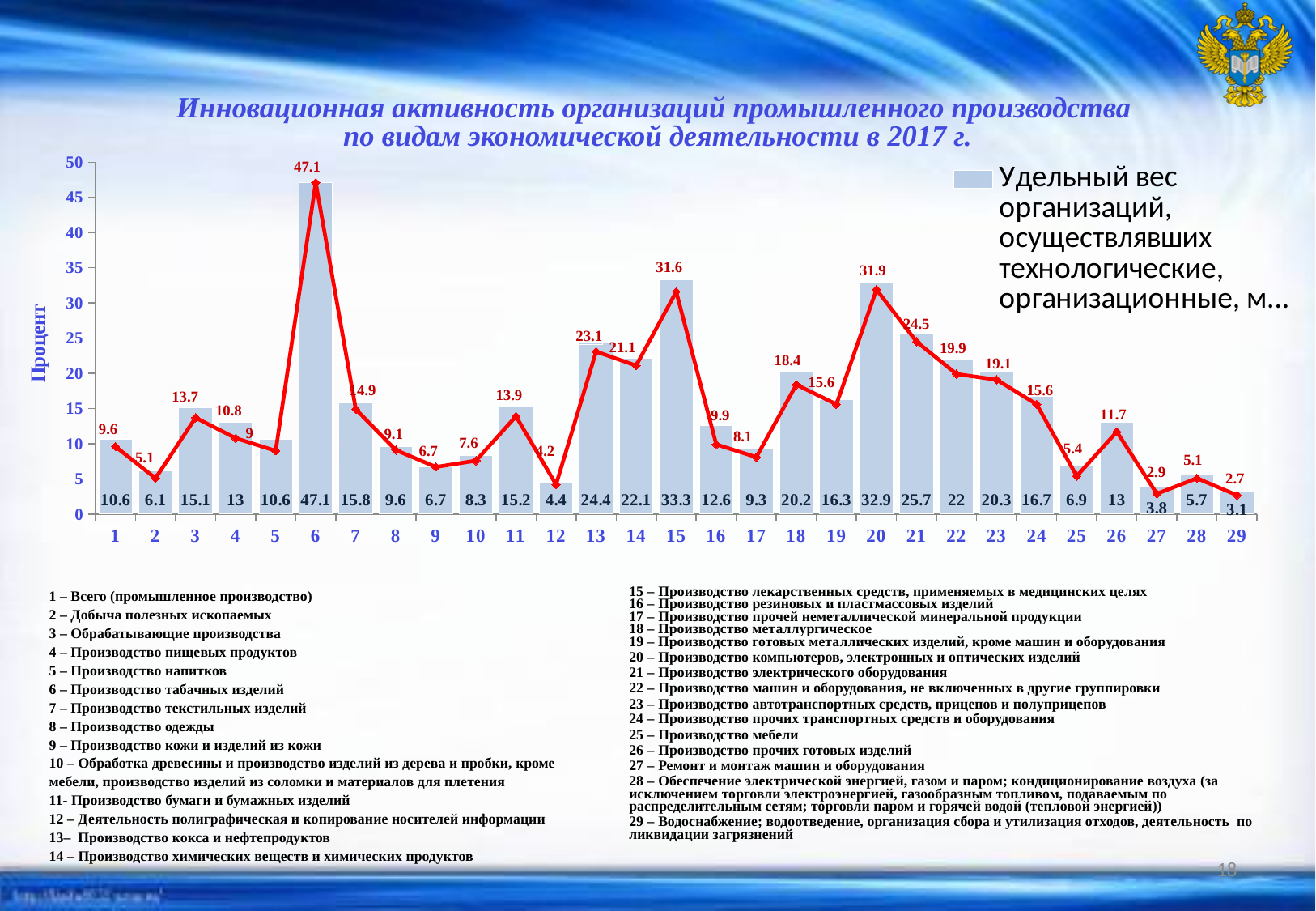
Which category has the lowest value on the red line? 29 What is the bar value for category 6 (Производство табачных изделий)? 47.1 What is the value of the red line at category 15 (Производство лекарственных средств)? 31.6 What is the bar value for category 1 (Всего, промышленное производство)? 10.6 Which is larger: the bar value for category 13 or the bar value for category 14? Category 13 Is the bar value for category 21 greater or less than 25? greater Which category has the highest bar value? 6 What is the label on the vertical axis of the chart? Процент What kind of chart is shown on the slide? A bar chart combined with a line chart How many categories are shown on the x axis? 29 What is the difference between the bar value and the red line value for category 20? 1